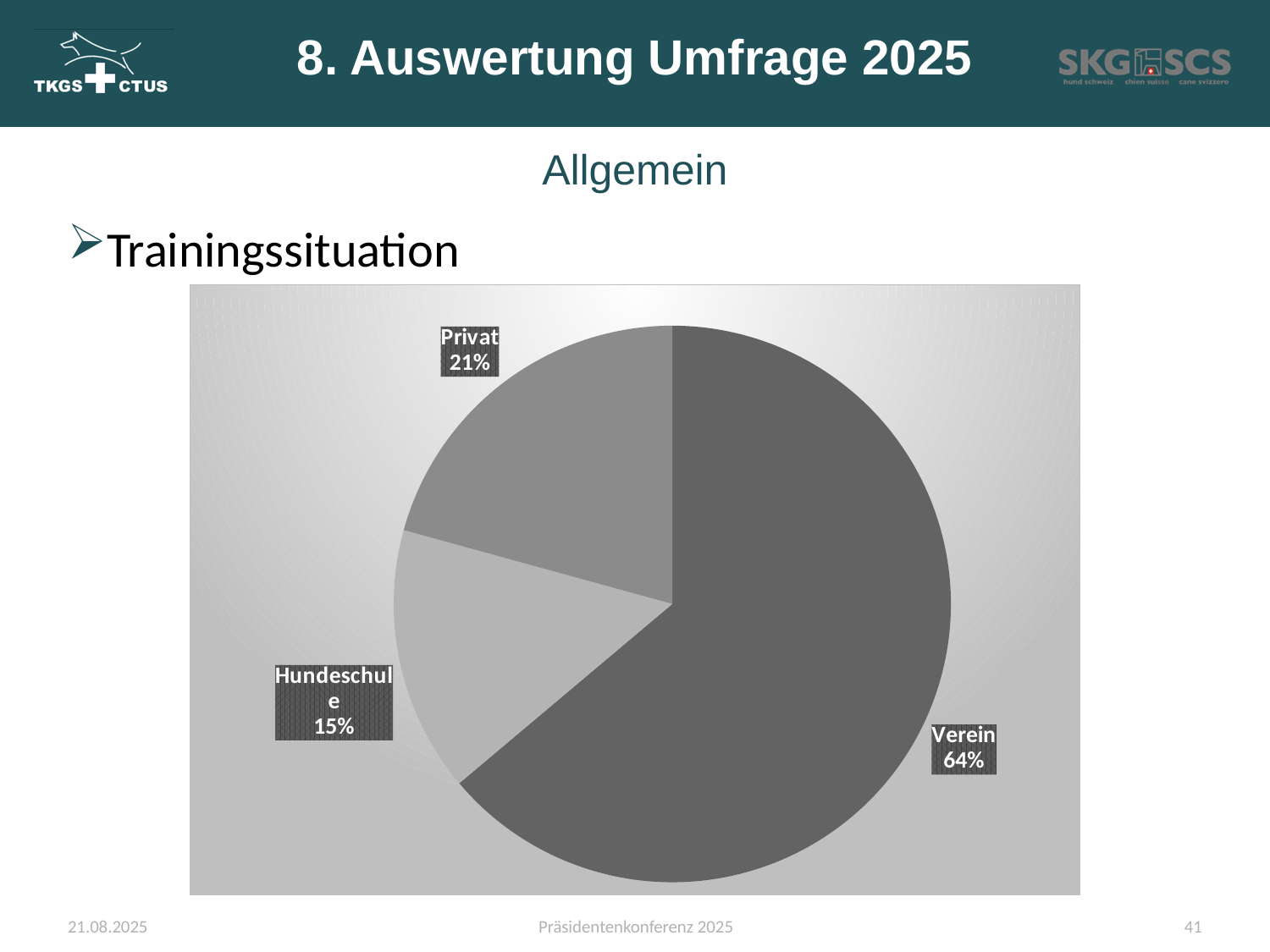
What is the difference in percentage points between Privat and Hundeschule? 6 Which is larger, the Privat slice or the Hundeschule slice? Privat What kind of chart is shown on the slide? pie chart Is the share for Verein greater or less than 50%? greater What is the heading above the pie chart on the slide? Trainingssituation What is the difference in percentage points between Verein and Privat? 43 Which category has the smallest slice of the pie? Hundeschule Which category has the largest slice of the pie? Verein How many slices does the pie chart have? 3 What share of the pie does Privat have? 21% What share of the pie does Hundeschule have? 15% What share of the pie does Verein have? 64%